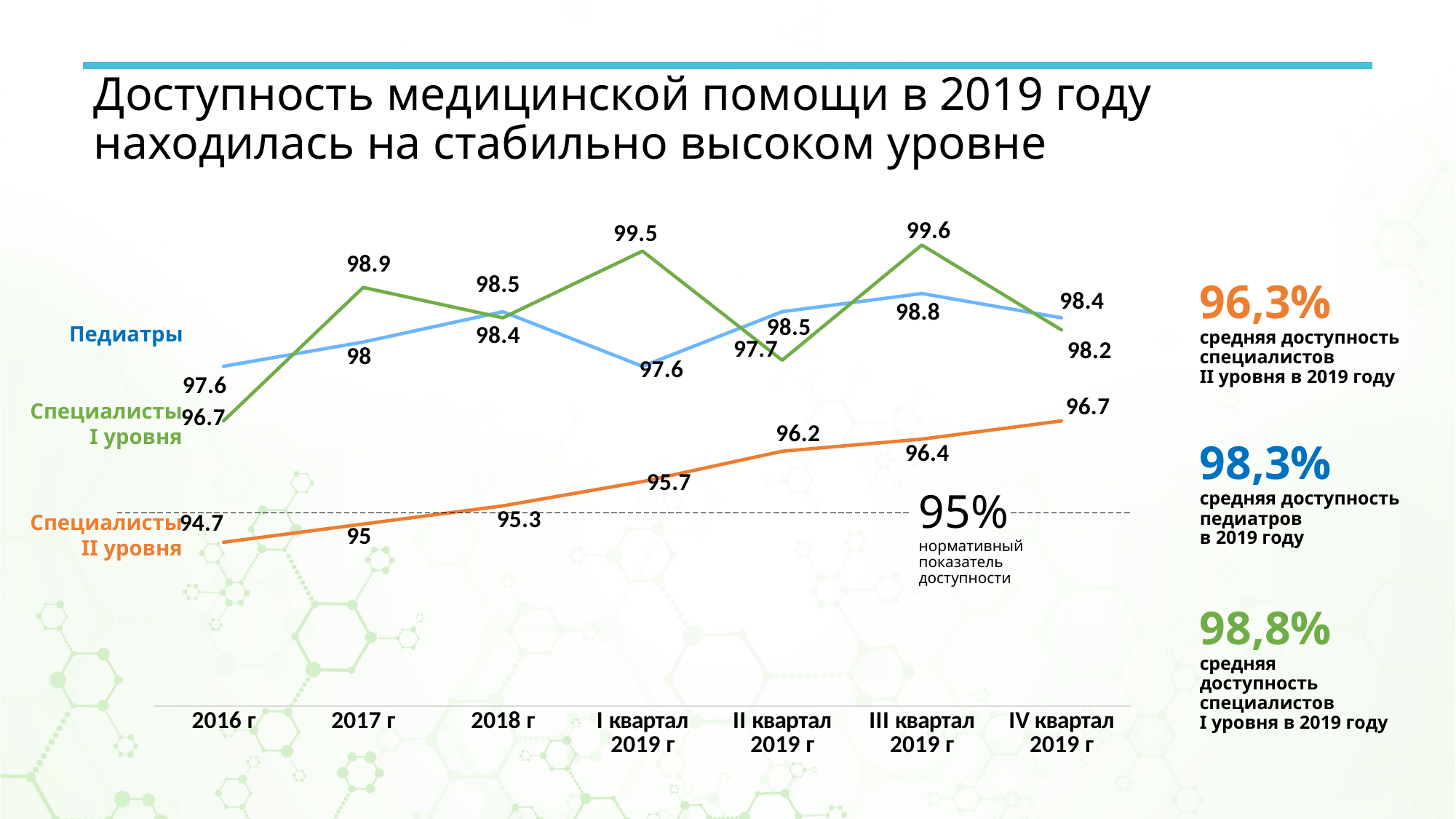
What is the value for Специалисты II уровня in 2016 г? 94.7 What is the value for Специалисты I уровня in I квартал 2019 г? 99.5 In I квартал 2019 г, which is higher: Педиатры or Специалисты I уровня? Специалисты I уровня What kind of chart is shown on the slide? line chart By how much did the Специалисты II уровня value increase from 2016 г to IV квартал 2019 г? 2 In which period does the Специалисты I уровня series reach its highest value? III квартал 2019 г How many periods are shown on the x axis? 7 Does the Специалисты II уровня series rise or fall from 2016 г to IV квартал 2019 г? rise What is the value for Педиатры in III квартал 2019 г? 98.8 In which period is the Специалисты II уровня series at its lowest? 2016 г Is the value for Специалисты II уровня in 2016 г greater or less than 95? less How many data series are plotted on the chart? 3